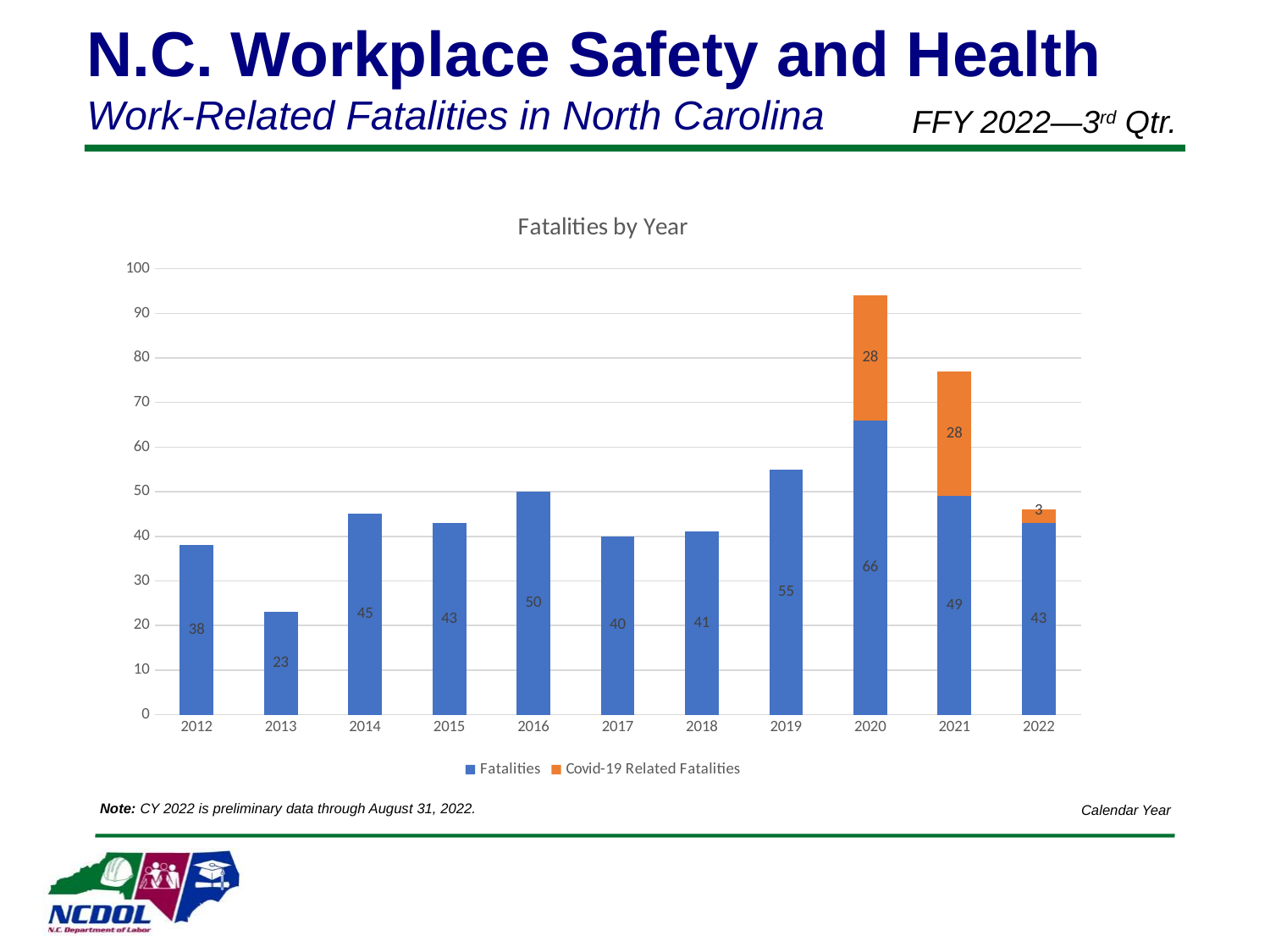
What type of chart is shown? Stacked bar chart What is the total of the stacked bar for 2022? 46 What is the value of Fatalities for 2016? 50 How many years are shown on the x axis? 11 How many series does the legend list? 2 What is the total of the stacked bar for 2020? 94 Which is larger, Fatalities in 2014 or Fatalities in 2015? 2014 Which year has the highest value for Fatalities? 2020 What is the value of Fatalities for 2013? 23 What is the difference between Fatalities in 2019 and 2018? 14 Which year has the lowest value for Fatalities? 2013 What is the value of Covid-19 Related Fatalities for 2021? 28